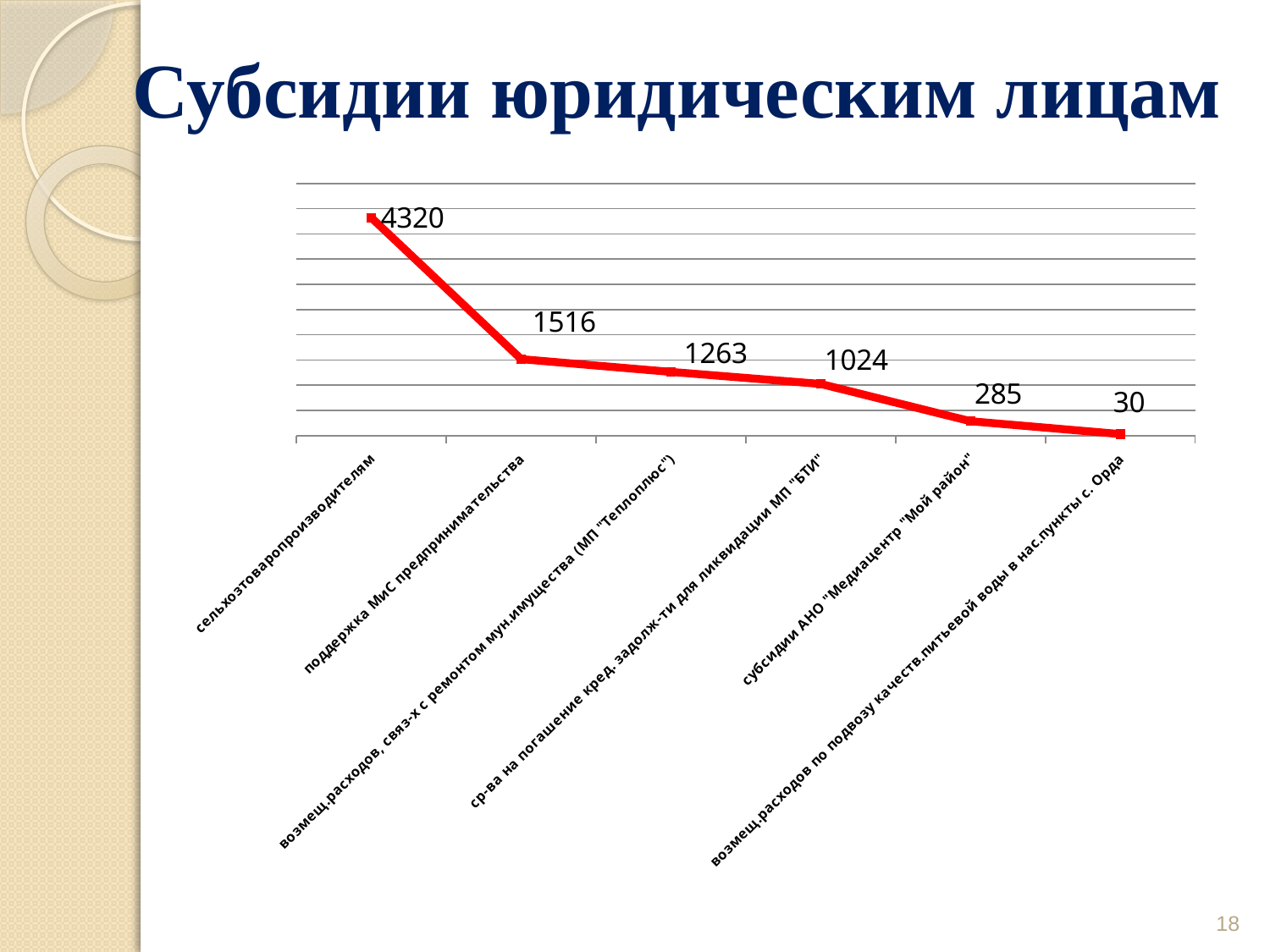
Which category has the highest value? сельхозтоваропроизводителям Which category has the lowest value? возмещ.расходов по подвозу качеств.питьевой воды в нас.пункты с. Орда What is the difference between the values for сельхозтоваропроизводителям and поддержка МиС предпринимательства? 2804 Do the values rise or fall from left to right along the x axis? fall What is the value for возмещ.расходов по подвозу качеств.питьевой воды в нас.пункты с. Орда? 30 How many categories are plotted on the chart? 6 What is the value for поддержка МиС предпринимательства? 1516 What is the value for ср-ва на погашение кред. задолж-ти для ликвидации МП "БТИ"? 1024 What is the value for сельхозтоваропроизводителям? 4320 What is the value for субсидии АНО "Медиацентр "Мой район""? 285 What kind of chart is shown on the slide? line chart Which is larger: the value for возмещ.расходов, связ-х с ремонтом мун.имущества (МП "Теплоплюс") or the value for субсидии АНО "Медиацентр "Мой район""? возмещ.расходов, связ-х с ремонтом мун.имущества (МП "Теплоплюс")